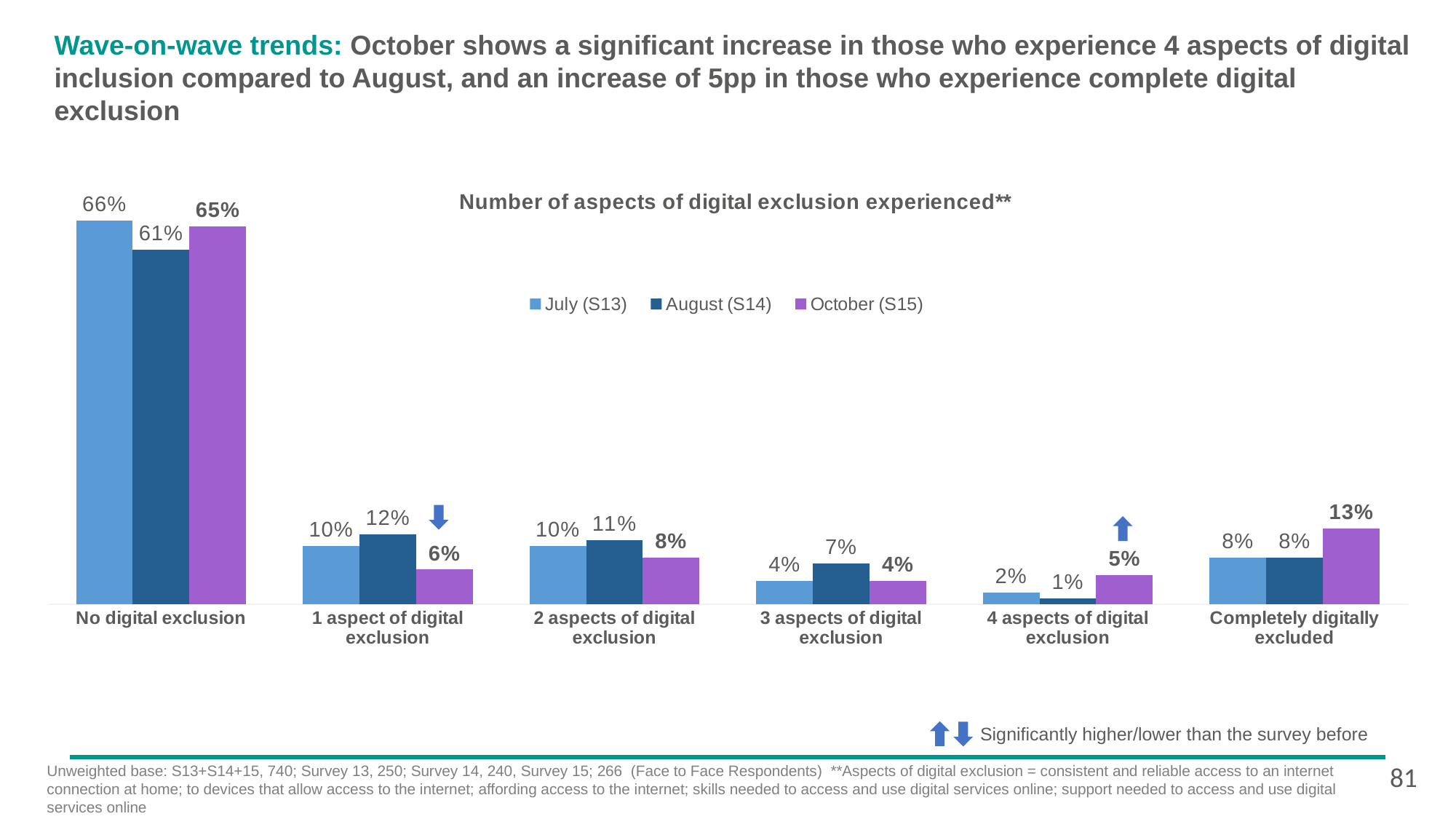
What is the title of the chart? Number of aspects of digital exclusion experienced** How many series does the legend list? 3 What is the August (S14) value for '1 aspect of digital exclusion'? 12% What is the October (S15) value for 'Completely digitally excluded'? 13% What is the difference between the October (S15) and August (S14) values for 'Completely digitally excluded'? 5% Which category has the lowest value for October (S15)? 3 aspects of digital exclusion What is the October (S15) value for 'No digital exclusion'? 65% Which is larger for '3 aspects of digital exclusion': the July (S13) value or the August (S14) value? August (S14) What is the July (S13) value for '4 aspects of digital exclusion'? 2% What kind of chart is shown on the slide? Bar chart Which category has the highest value for August (S14)? No digital exclusion How many categories are shown on the x axis? 6